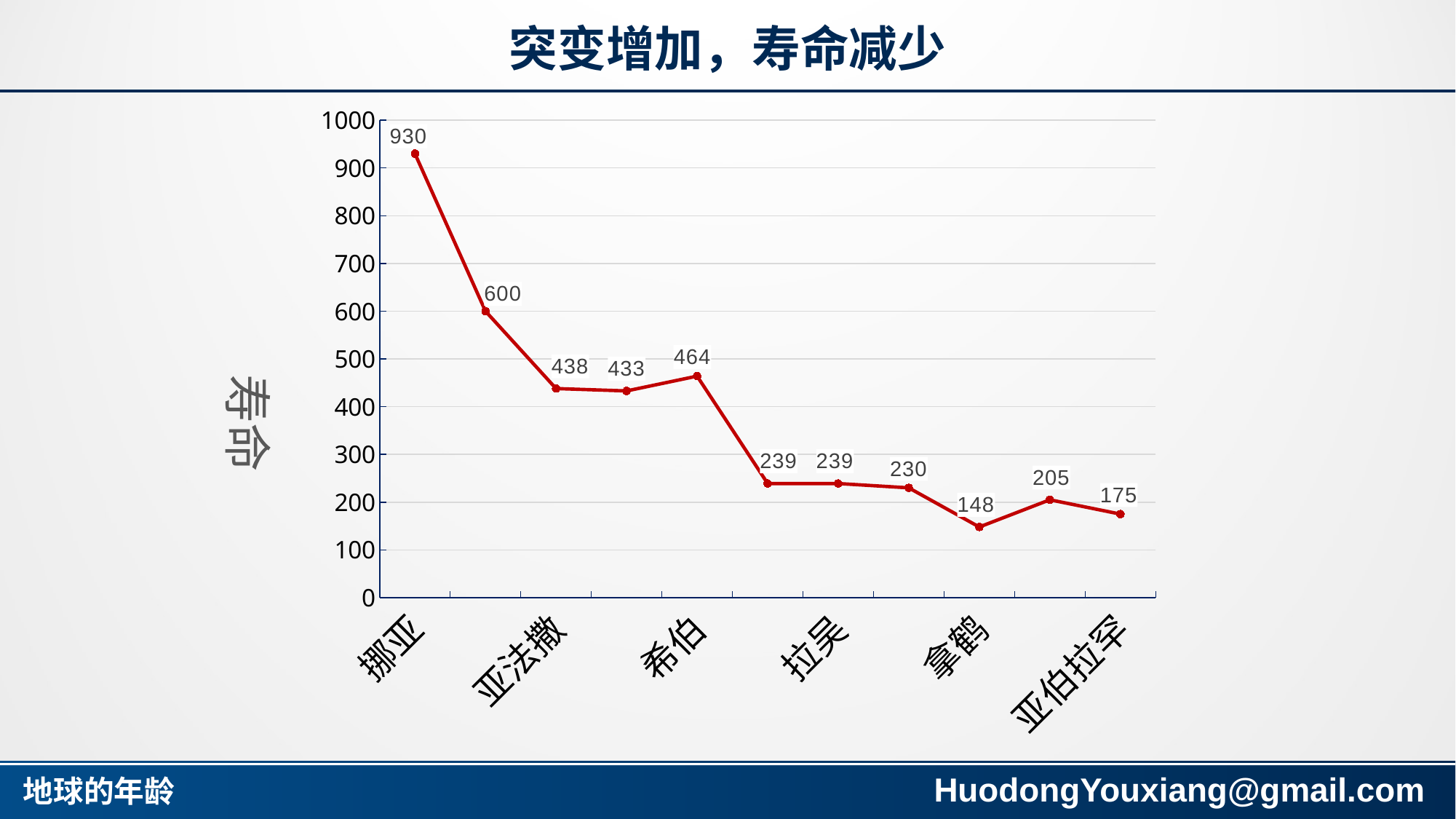
What type of chart is shown on the slide? line chart What is the difference between the values for 挪亚 and 亚伯拉罕? 755 What is the value for 希伯? 464 Which labeled category has the highest value? 挪亚 Which labeled category has the lowest value? 拿鹤 What is the value for 拿鹤? 148 How many data points are plotted on the line? 11 What is the value for 挪亚? 930 Which is larger, the value for 希伯 or the value for 拉吴? 希伯 What is the value for 亚法撒? 438 Do the values generally rise or fall from left to right along the x axis? fall What is the value for 亚伯拉罕? 175